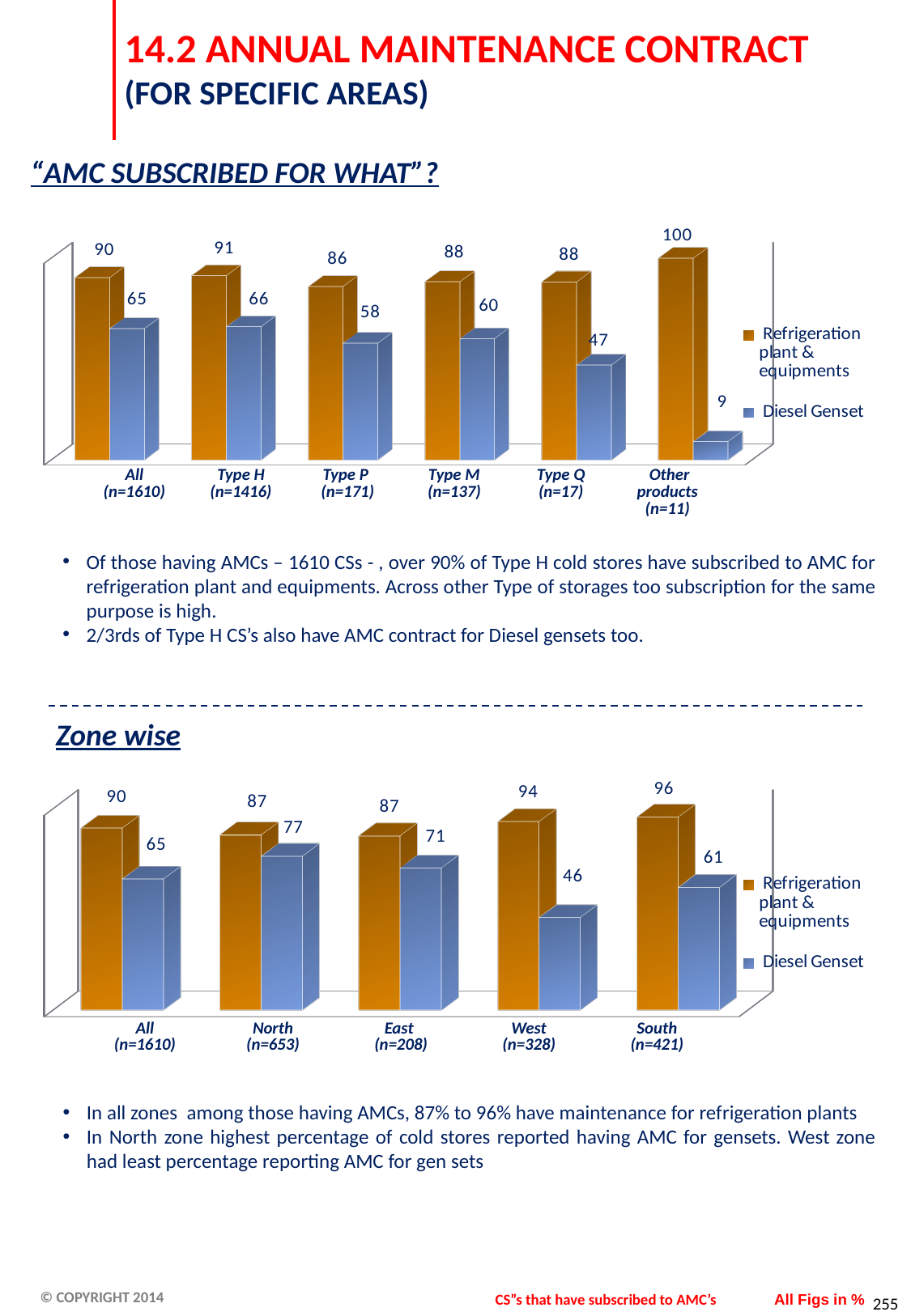
In the top chart ("AMC subscribed for what?"), what is the Diesel Genset value for Type Q? 47 In the top chart ("AMC subscribed for what?"), which category has the highest Refrigeration plant & equipments value? Other products (n=11) In the bottom chart (Zone wise), what is the difference between the Refrigeration plant & equipments value and the Diesel Genset value for West? 48 In the top chart ("AMC subscribed for what?"), which category has the lowest Diesel Genset value? Other products (n=11) How many series does the legend of the bottom chart (Zone wise) list? 2 In the bottom chart (Zone wise), which zone has the lowest Diesel Genset value? West (n=328) In the bottom chart (Zone wise), what is the Diesel Genset value for North? 77 In the top chart ("AMC subscribed for what?"), how many categories are shown on the x axis? 6 In the top chart ("AMC subscribed for what?"), what is the value for Refrigeration plant & equipments for Type P? 86 In the top chart ("AMC subscribed for what?"), what is the difference between the Refrigeration plant & equipments value and the Diesel Genset value for Type H? 25 In the bottom chart (Zone wise), is the Diesel Genset value larger for East or for South? East In the bottom chart (Zone wise), what is the Refrigeration plant & equipments value for South? 96